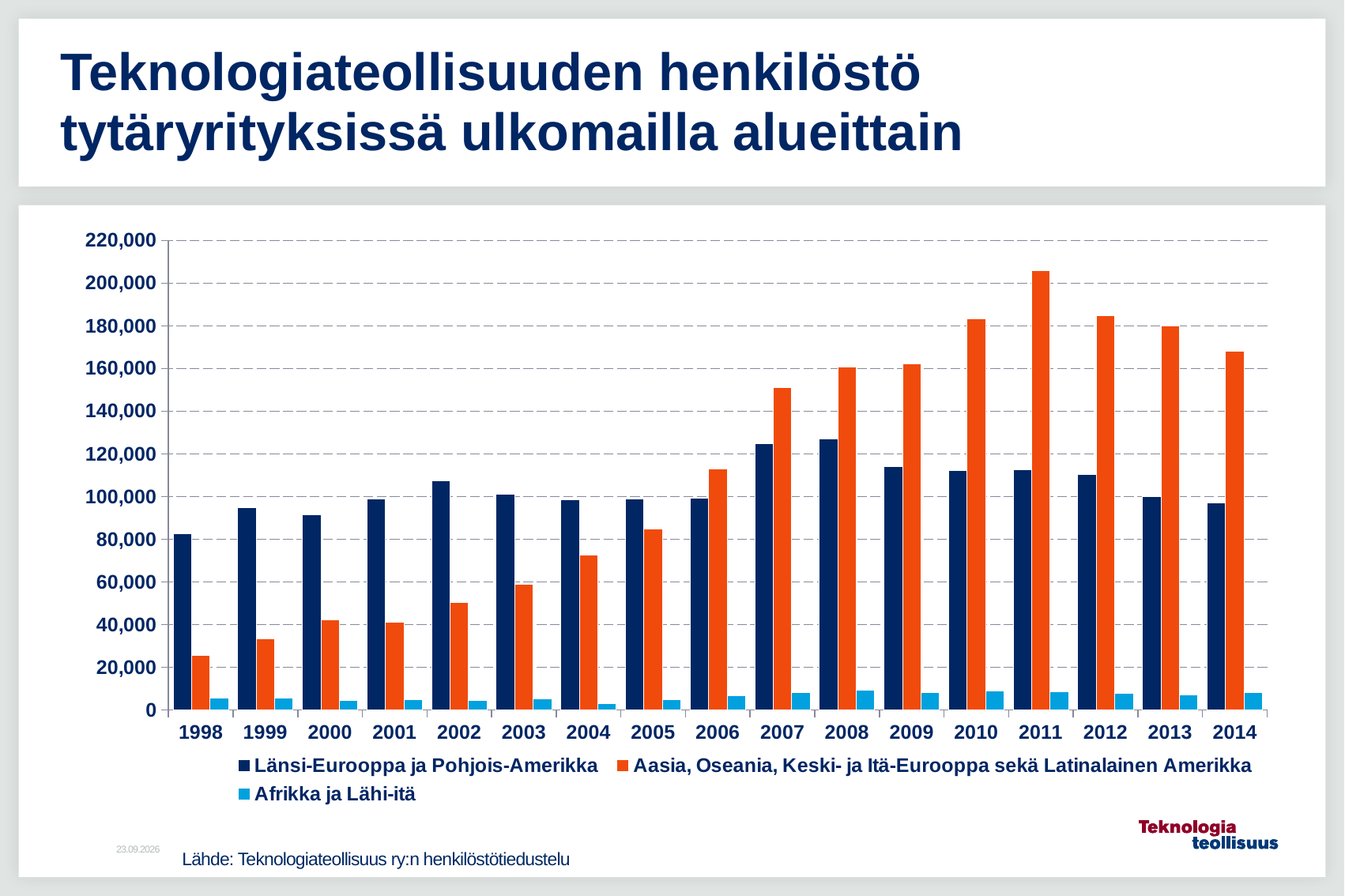
Is the 1998 value for Länsi-Eurooppa ja Pohjois-Amerikka greater or less than 100,000? less What kind of chart is shown on the slide? Bar chart In which year is the value for Länsi-Eurooppa ja Pohjois-Amerikka lowest? 1998 How many series does the legend list? 3 In which year is the value for Aasia, Oseania, Keski- ja Itä-Eurooppa sekä Latinalainen Amerikka highest? 2011 How many years are shown on the x axis? 17 Is the 2011 value for Aasia, Oseania, Keski- ja Itä-Eurooppa sekä Latinalainen Amerikka greater or less than 200,000? greater In which year is the value for Aasia, Oseania, Keski- ja Itä-Eurooppa sekä Latinalainen Amerikka lowest? 1998 Does the value for Aasia, Oseania, Keski- ja Itä-Eurooppa sekä Latinalainen Amerikka rise or fall from 1998 to 2011? Rise In 2006, which series has the larger value: Länsi-Eurooppa ja Pohjois-Amerikka or Aasia, Oseania, Keski- ja Itä-Eurooppa sekä Latinalainen Amerikka? Aasia, Oseania, Keski- ja Itä-Eurooppa sekä Latinalainen Amerikka Is the 2007 value for Aasia, Oseania, Keski- ja Itä-Eurooppa sekä Latinalainen Amerikka greater or less than 140,000? greater In 2005, which series has the larger value: Länsi-Eurooppa ja Pohjois-Amerikka or Aasia, Oseania, Keski- ja Itä-Eurooppa sekä Latinalainen Amerikka? Länsi-Eurooppa ja Pohjois-Amerikka